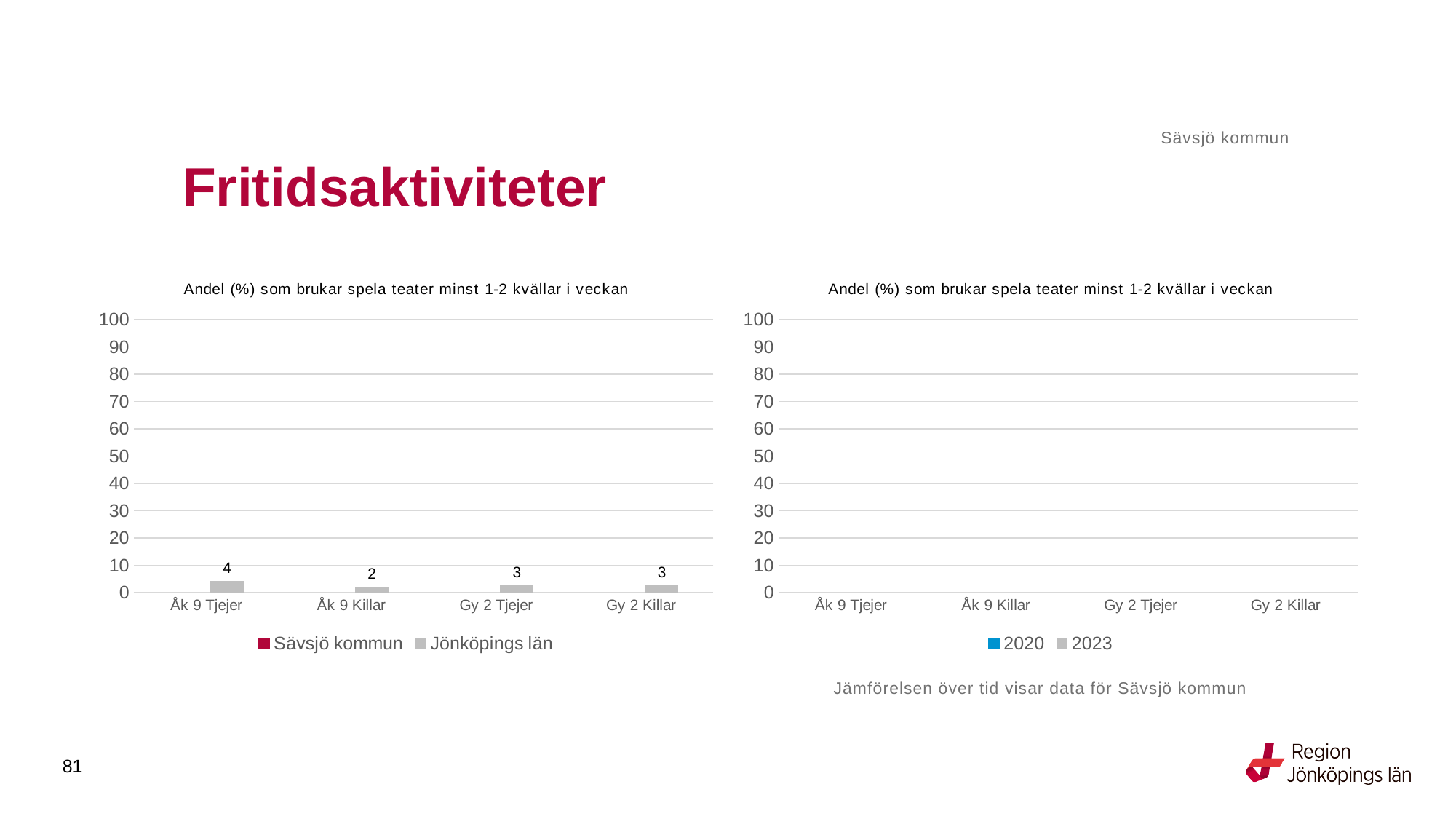
In the left chart, what is the value for Jönköpings län for Åk 9 Killar? 2 In the left chart, what is the value for Jönköpings län for Gy 2 Killar? 3 In the left chart, which category has the lowest value for Jönköpings län? Åk 9 Killar In the left chart, is the Jönköpings län value for Åk 9 Tjejer greater or less than 10? less In the left chart, which category has the highest value for Jönköpings län? Åk 9 Tjejer In the left chart, what is the value for Jönköpings län for Gy 2 Tjejer? 3 In the left chart, what is the difference between the Jönköpings län values for Åk 9 Tjejer and Åk 9 Killar? 2 In the left chart, how many series does the legend list? 2 In the left chart, how many categories are shown on the x axis? 4 In the right chart, which two years does the legend list? 2020 and 2023 What kind of chart is the left chart? bar chart In the left chart, what is the value for Jönköpings län for Åk 9 Tjejer? 4